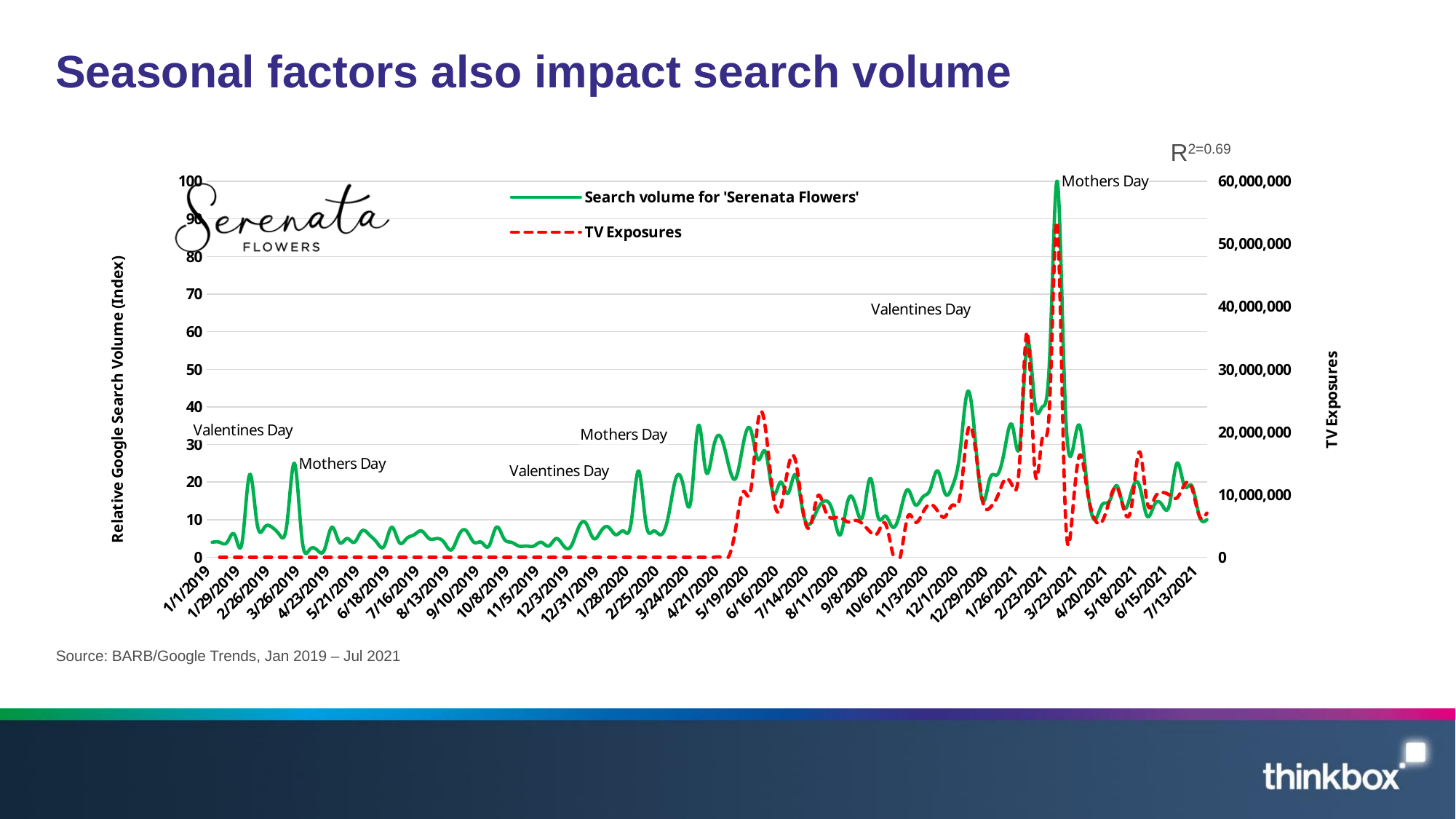
Is the peak TV Exposures value in early 2021 greater or less than 50,000,000? greater Is the search volume for 'Serenata Flowers' at the Mothers Day 2020 peak greater or less than 30? greater Is the search volume for 'Serenata Flowers' at the Mothers Day 2019 peak greater or less than 30? less What is the TV Exposures value on 1/1/2019? 0 Which series is drawn as a red dashed line? TV Exposures Which seasonal event is annotated at the highest peak of the search volume line? Mothers Day How many series does the chart's legend list? 2 What type of chart is shown on the slide? Line chart What R-squared value is shown on the chart? R2=0.69